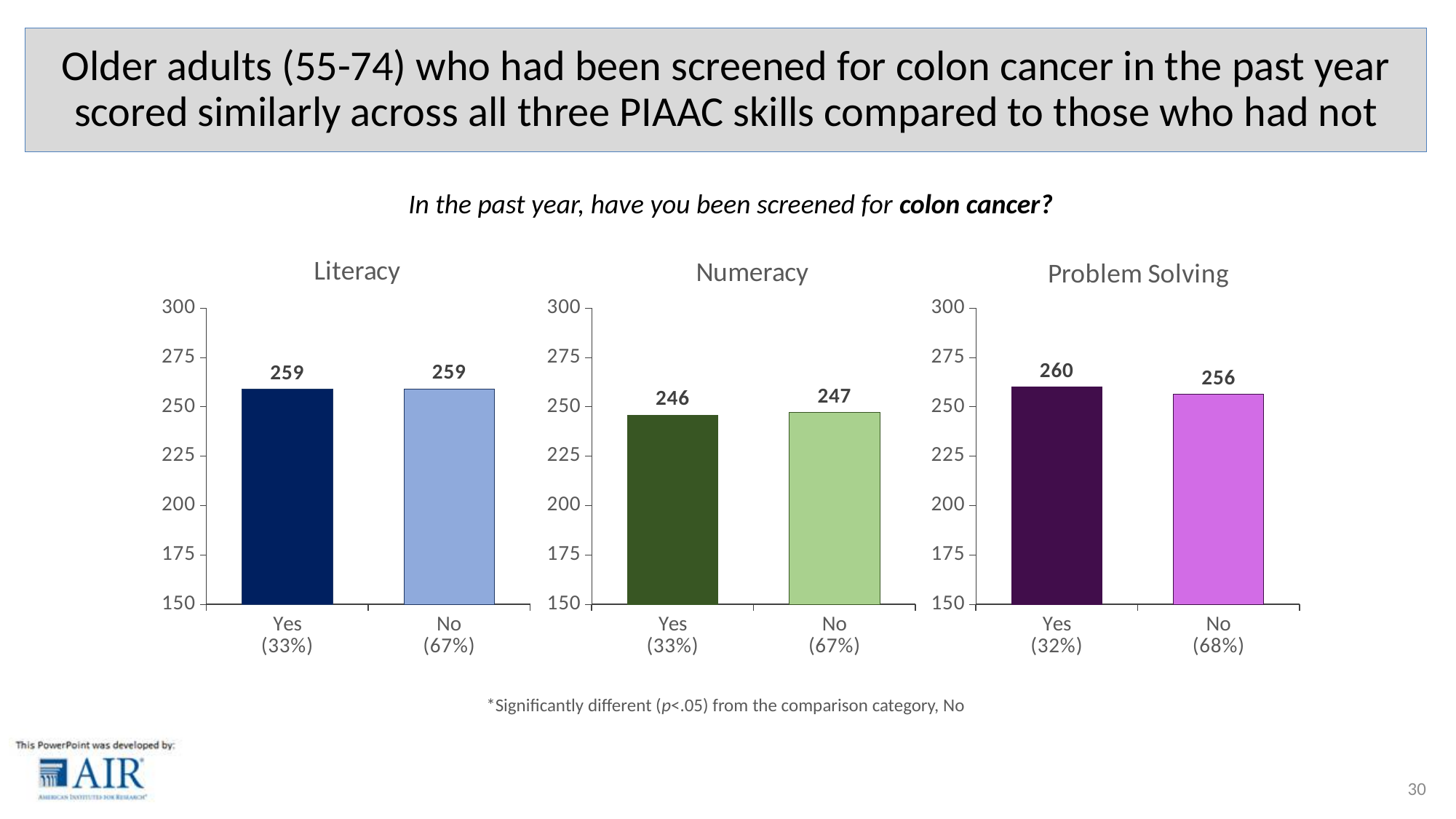
How many categories does the Literacy chart show? 2 In the Literacy chart, what is the value for Yes (33%)? 259 What kind of chart is the Numeracy chart? bar chart In the Numeracy chart, what is the value for No (67%)? 247 In the Numeracy chart, what is the difference between the No and Yes values? 1 In the Problem Solving chart, which category has the highest value? Yes (32%) In the Problem Solving chart, what is the value for No (68%)? 256 In the Numeracy chart, is the value for Yes (33%) greater or less than 250? less In the Numeracy chart, which category has the lowest value? Yes (33%) In the Literacy chart, is the value for No (67%) greater or less than 250? greater In the Problem Solving chart, what is the difference between the Yes and No values? 4 In the Problem Solving chart, what is the value for Yes (32%)? 260